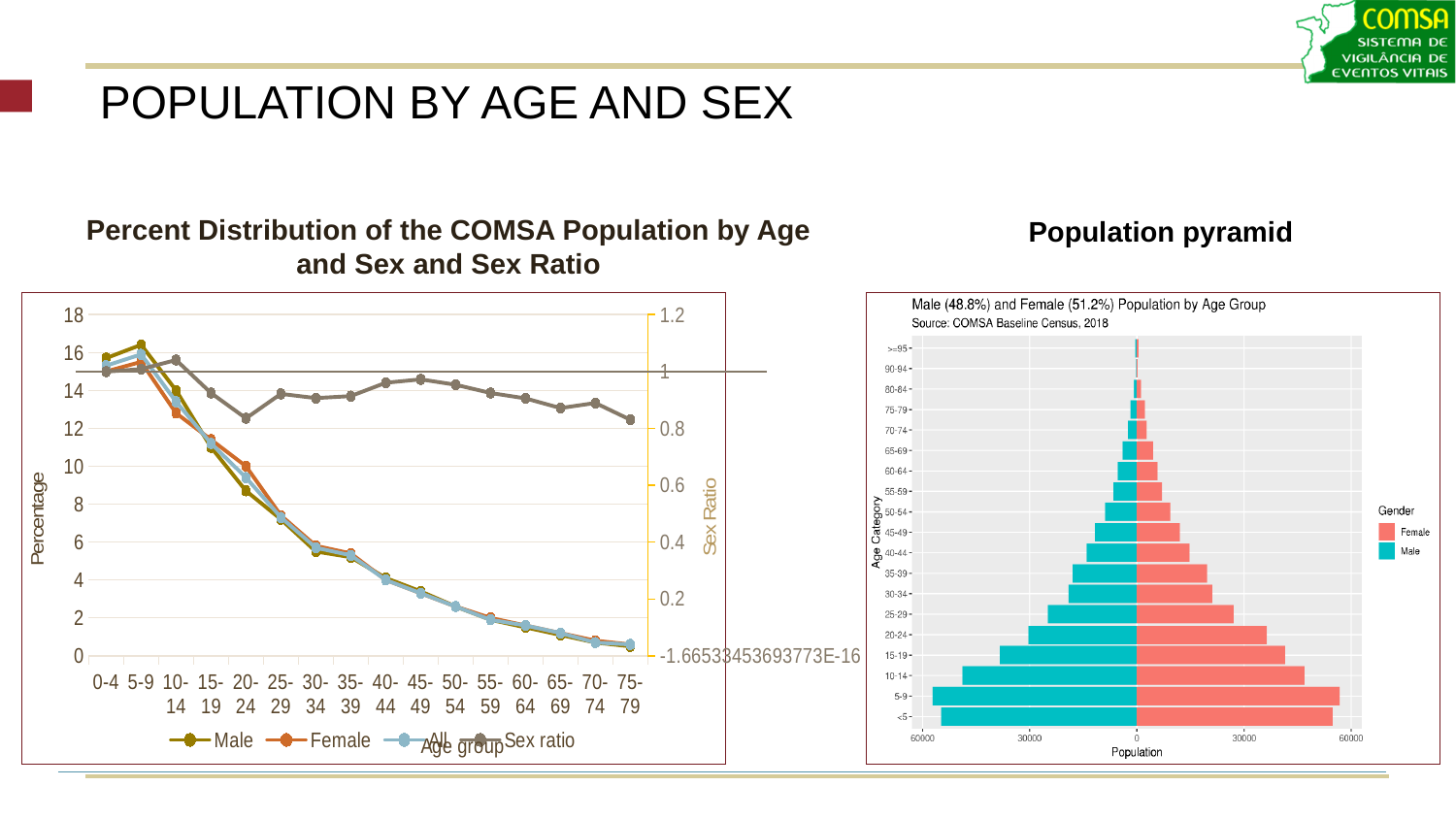
How many age groups are shown on the x axis of the 'Percent Distribution of the COMSA Population by Age and Sex and Sex Ratio' chart? 16 In the 'Percent Distribution of the COMSA Population by Age and Sex and Sex Ratio' chart, is the Sex ratio for the 20-24 age group greater or less than 1? less In the 'Population pyramid' chart, what percentage of the population is Female according to the chart title? 51.2% In the 'Percent Distribution of the COMSA Population by Age and Sex and Sex Ratio' chart, which age group has the highest Male percentage? 5-9 In the 'Percent Distribution of the COMSA Population by Age and Sex and Sex Ratio' chart, is the Female percentage for the 75-79 age group greater or less than 2? less In the 'Percent Distribution of the COMSA Population by Age and Sex and Sex Ratio' chart, do the Male, Female and All percentages generally rise or fall from the 5-9 age group to the 75-79 age group? Fall In the 'Population pyramid' chart, which age category has the longest bars for both Male and Female? 5-9 In the 'Percent Distribution of the COMSA Population by Age and Sex and Sex Ratio' chart, which age group has the lowest Female percentage? 75-79 How many series does the legend of the 'Percent Distribution of the COMSA Population by Age and Sex and Sex Ratio' chart list? 4 In the 'Percent Distribution of the COMSA Population by Age and Sex and Sex Ratio' chart, is the Male percentage for the 0-4 age group greater or less than 14? greater What kind of chart is the 'Population pyramid' on the right of the slide? Bar chart What kind of chart is the 'Percent Distribution of the COMSA Population by Age and Sex and Sex Ratio' chart? Line chart